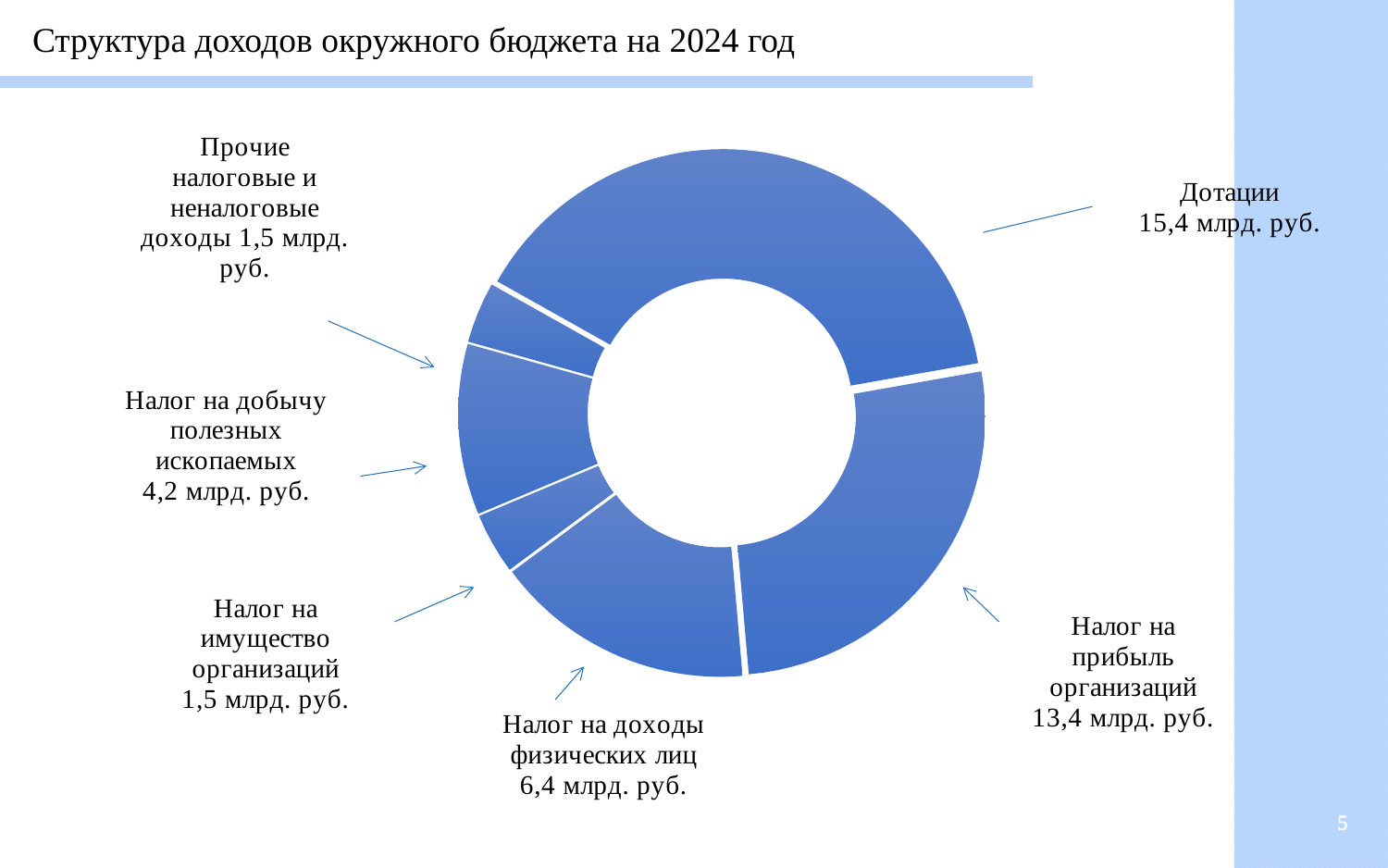
What kind of chart is shown on the slide? Donut (pie) chart What is the value for Налог на имущество организаций? 1,5 млрд. руб. What is the value for Налог на доходы физических лиц? 6,4 млрд. руб. What is the value for Дотации? 15,4 млрд. руб. What is the difference between Налог на добычу полезных ископаемых and Прочие налоговые и неналоговые доходы? 2,7 млрд. руб. Which category has the largest value? Дотации Which is larger: Налог на доходы физических лиц or Налог на добычу полезных ископаемых? Налог на доходы физических лиц What is the title of the slide? Структура доходов окружного бюджета на 2024 год What is the value for Налог на добычу полезных ископаемых? 4,2 млрд. руб. What is the value for Налог на прибыль организаций? 13,4 млрд. руб. How many segments does the chart have? 6 What is the difference between Дотации and Налог на прибыль организаций? 2,0 млрд. руб.